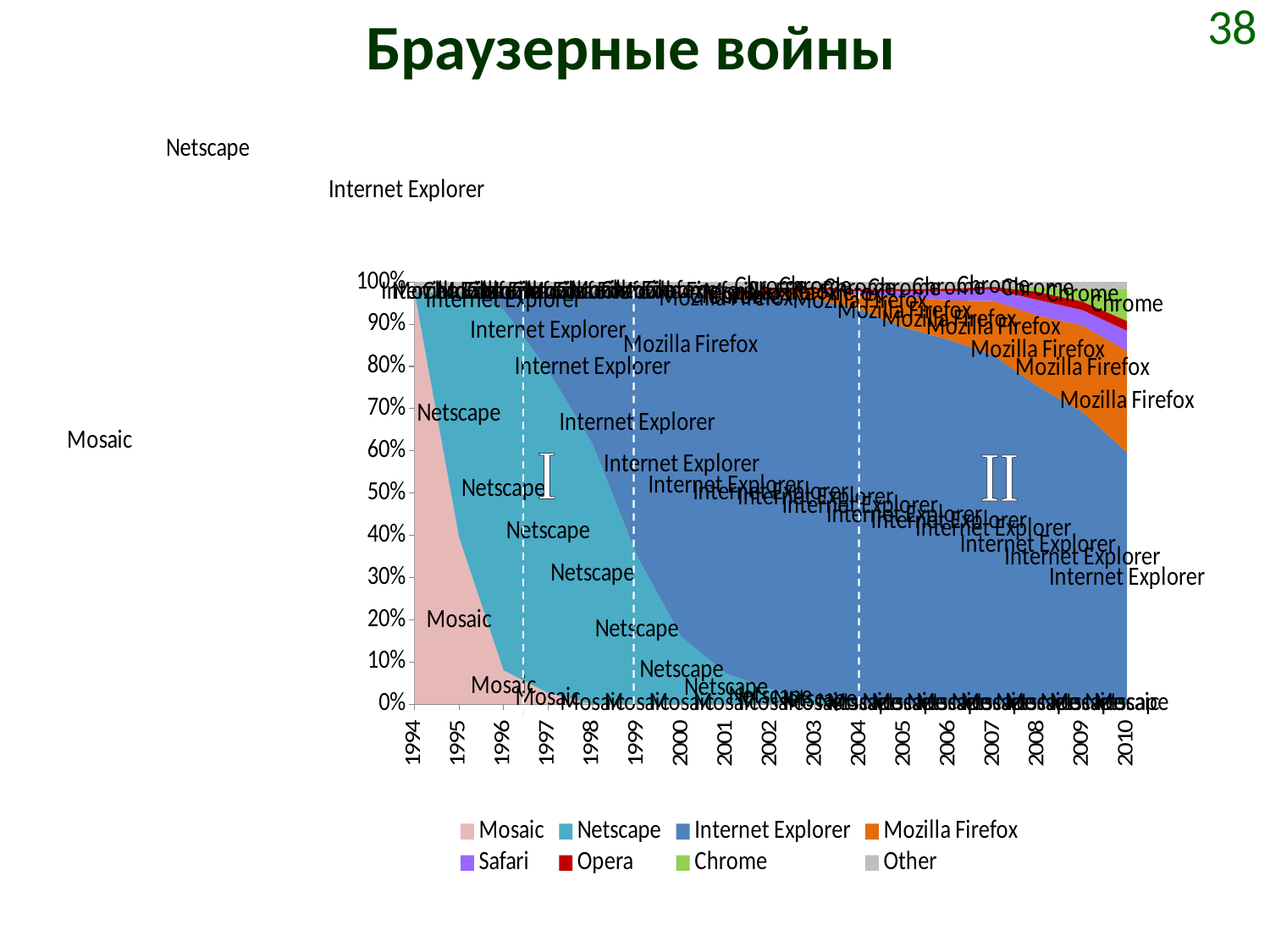
Which browser has the largest share in 2010? Internet Explorer In 1996, which has the larger share, Netscape or Internet Explorer? Netscape Which browser has the largest share in 1994? Mosaic Is the share of Mosaic in 1995 greater or less than 50%? less Does the share of Mosaic rise or fall from 1994 to 1997? fall How many series does the legend list? 8 What kind of chart is shown on the slide? area chart What is the title of the slide containing the chart? Браузерные войны How many years are shown along the x axis? 17 Is the share of Internet Explorer in 2004 greater or less than 80%? greater Is the share of Mozilla Firefox in 2010 greater or less than 10%? greater In 2004, which has the larger share, Internet Explorer or Mozilla Firefox? Internet Explorer